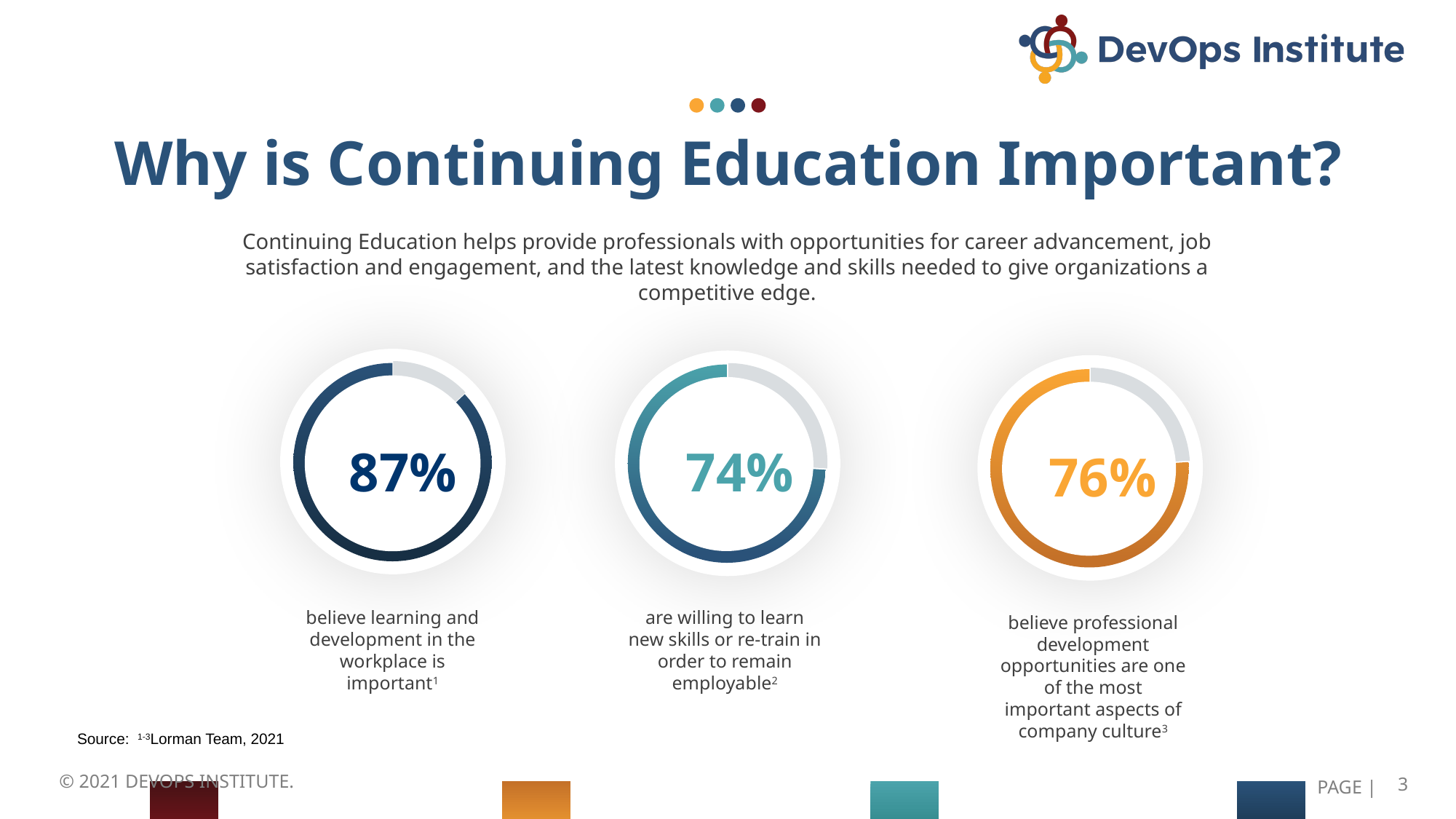
What is the difference between the left chart's value (87%) and the middle chart's value (74%)? 13 percentage points What percentage is shown in the middle donut chart (are willing to learn new skills or re-train in order to remain employable)? 74% What is the difference between the left chart's value (87%) and the right chart's value (76%)? 11 percentage points What is the difference between the right chart's value (76%) and the middle chart's value (74%)? 2 percentage points Which is larger: the percentage in the middle donut chart or the percentage in the right donut chart? The right chart (76%) What colour is the filled ring of the right donut chart? Orange What percentage is shown in the left donut chart (believe learning and development in the workplace is important)? 87% What percentage is shown in the right donut chart (believe professional development opportunities are one of the most important aspects of company culture)? 76% Which of the three donut charts shows the highest percentage? The left chart, 87% (believe learning and development in the workplace is important) How many donut charts are shown on the slide? 3 What kind of chart is used to display the three percentages on the slide? Donut chart Which of the three donut charts shows the lowest percentage? The middle chart, 74% (are willing to learn new skills or re-train)